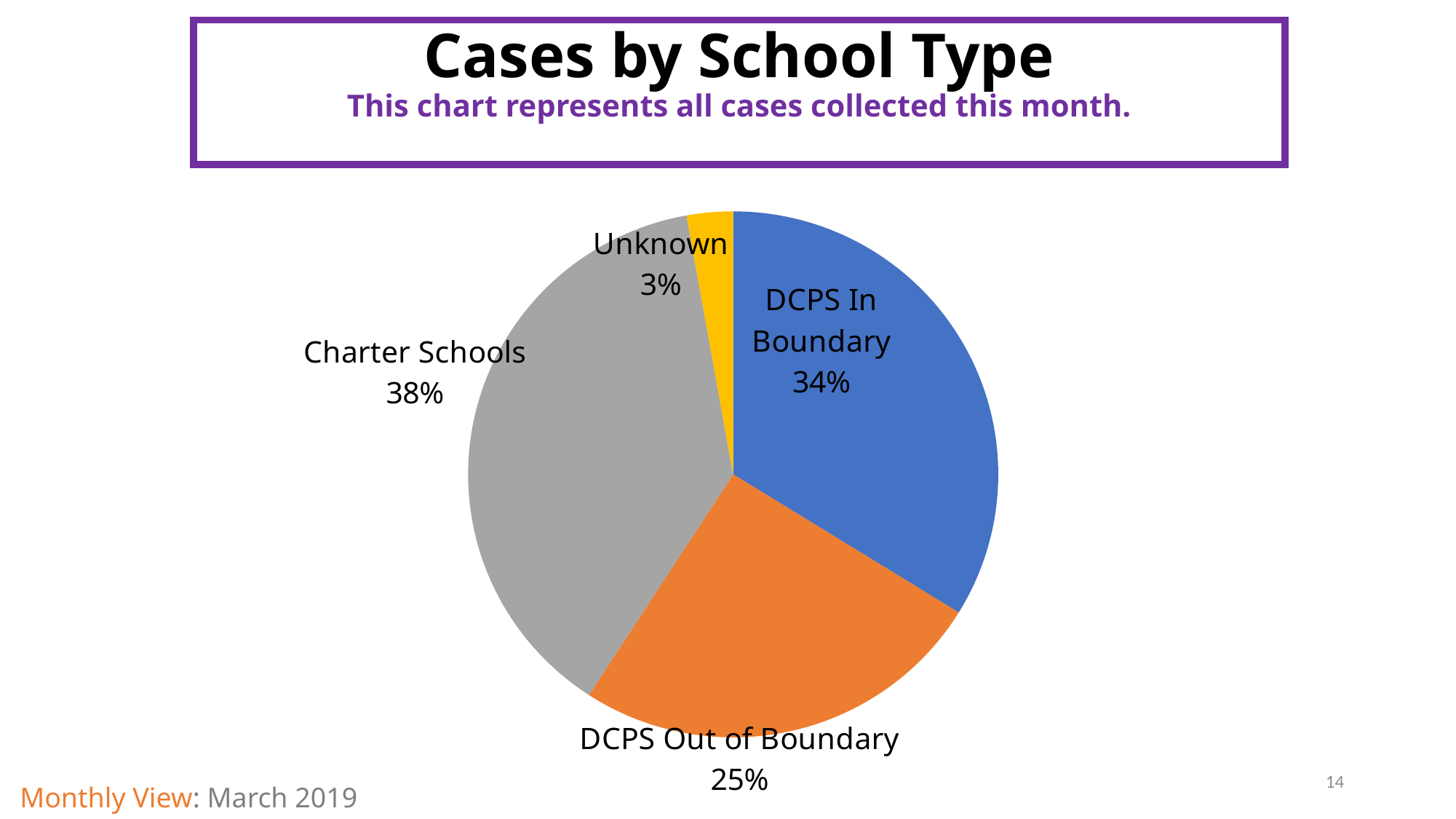
What is the title of the chart? Cases by School Type What percentage of cases is DCPS In Boundary? 34% Which school type has the largest share of cases? Charter Schools Which school type has the smallest share of cases? Unknown How many school type categories are shown in the pie chart? 4 Which is larger, the share for DCPS In Boundary or DCPS Out of Boundary? DCPS In Boundary What is the difference in percentage points between Charter Schools and DCPS Out of Boundary? 13 What share of cases is attributed to Charter Schools? 38% What percentage of cases is DCPS Out of Boundary? 25% What colour is the Charter Schools slice? Grey What kind of chart is shown on the slide? Pie chart What share of cases is labelled Unknown? 3%